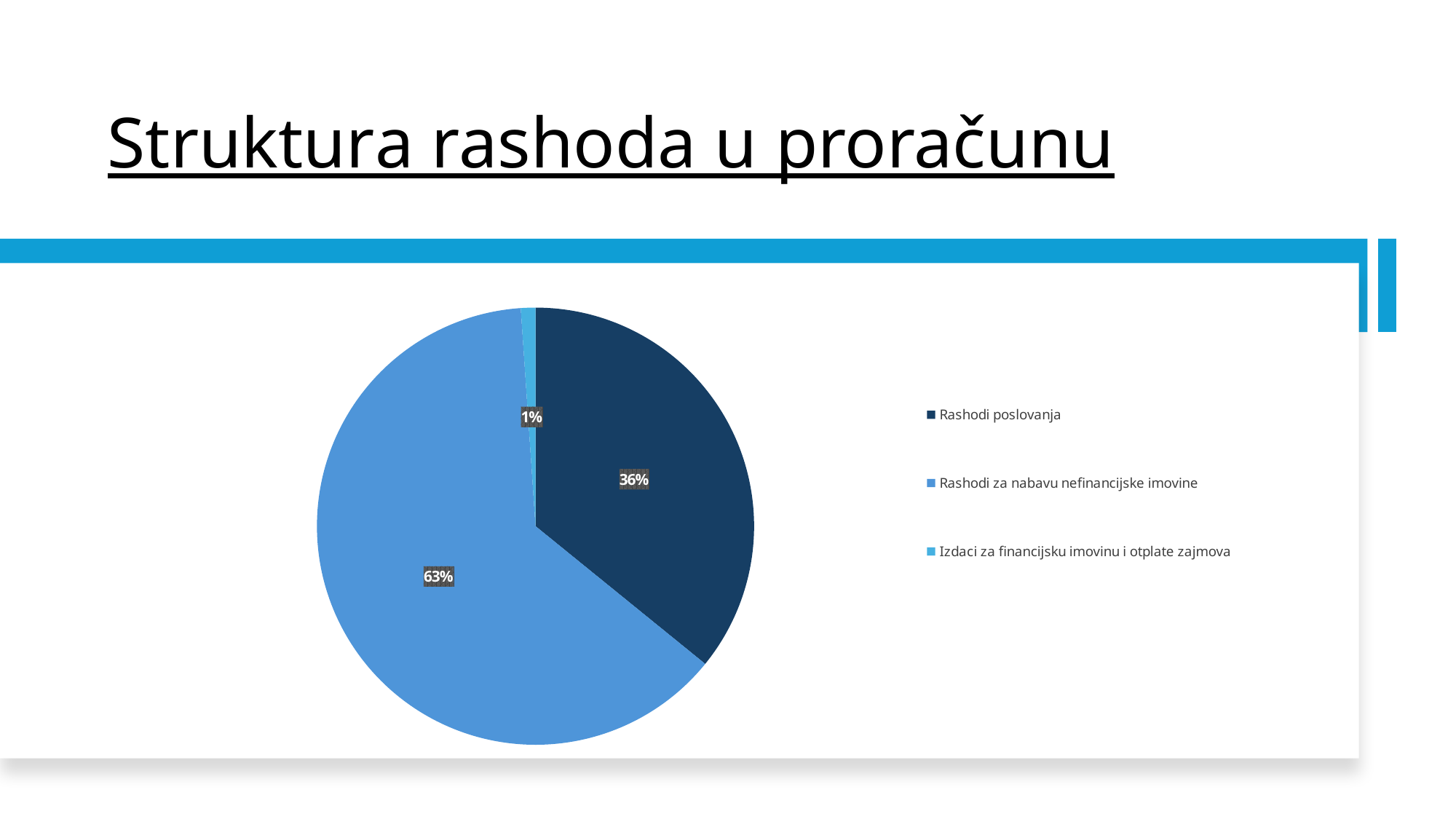
What is the title of the slide? Struktura rashoda u proračunu Which category has the largest slice of the pie? Rashodi za nabavu nefinancijske imovine Which category has the smallest slice of the pie? Izdaci za financijsku imovinu i otplate zajmova What kind of chart is shown on the slide? pie chart Which is larger: Rashodi poslovanja or Rashodi za nabavu nefinancijske imovine? Rashodi za nabavu nefinancijske imovine What share of the pie does Izdaci za financijsku imovinu i otplate zajmova have? 1% What share of the pie does Rashodi poslovanja have? 36% Which category is shown in the darkest blue colour? Rashodi poslovanja What share of the pie does Rashodi za nabavu nefinancijske imovine have? 63% How many slices does the pie chart have? 3 What is the difference in percentage points between Rashodi za nabavu nefinancijske imovine and Rashodi poslovanja? 27 How many entries does the legend list? 3